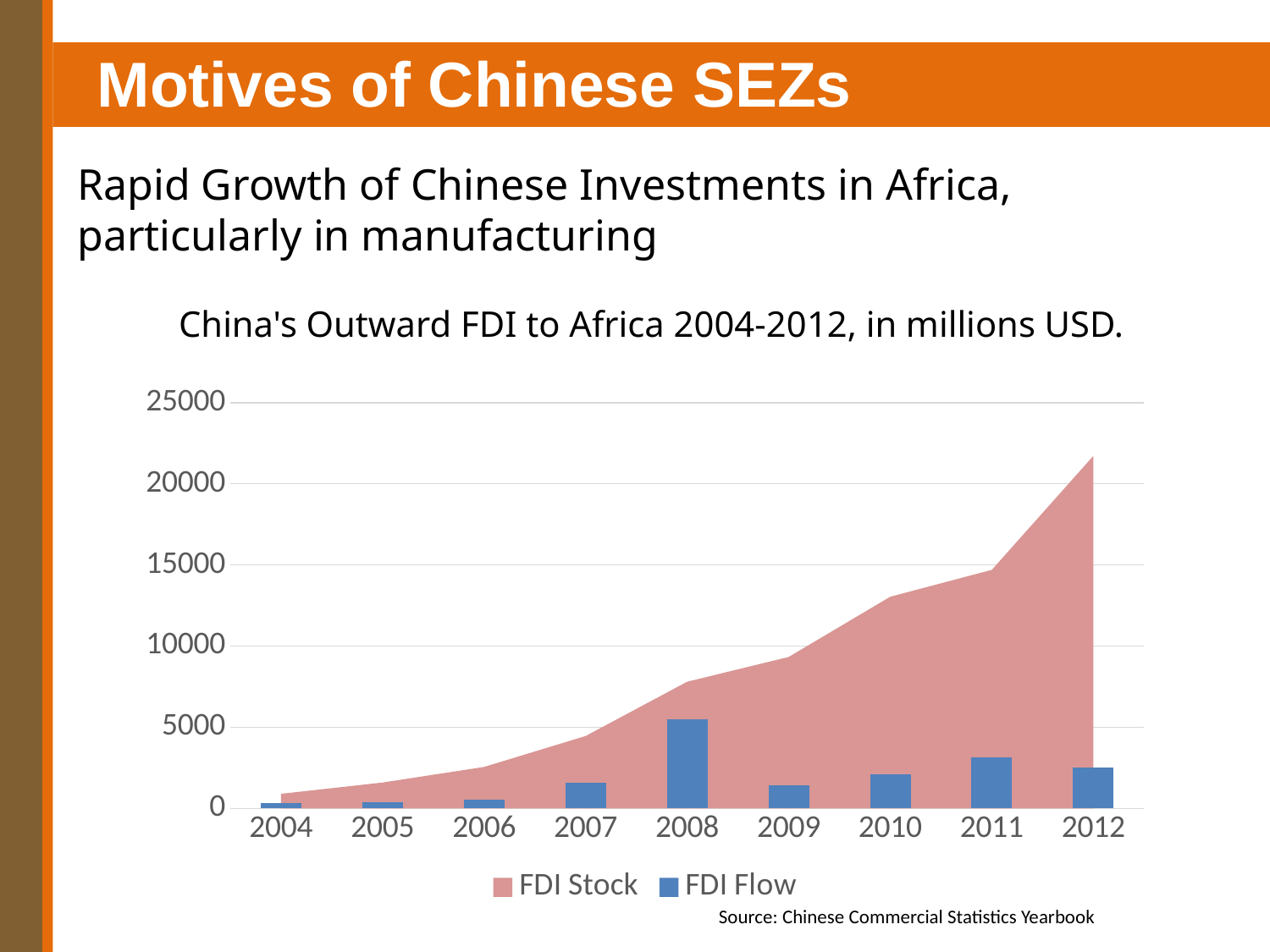
Is the FDI Stock value for 2007 greater or less than 5000? less Which is larger, FDI Flow in 2008 or FDI Flow in 2011? 2008 In which year is FDI Flow highest? 2008 How many years are shown on the x axis of the chart? 9 In which year is FDI Stock highest? 2012 Does FDI Stock rise or fall from 2004 to 2012? rise How many series does the chart legend list? 2 Is the FDI Stock value for 2012 greater or less than 20000? greater Is the FDI Flow value for 2008 greater or less than 5000? greater In which year is FDI Flow lowest? 2004 Which series is drawn as bars in the chart? FDI Flow What is the title of the chart? China's Outward FDI to Africa 2004-2012, in millions USD.